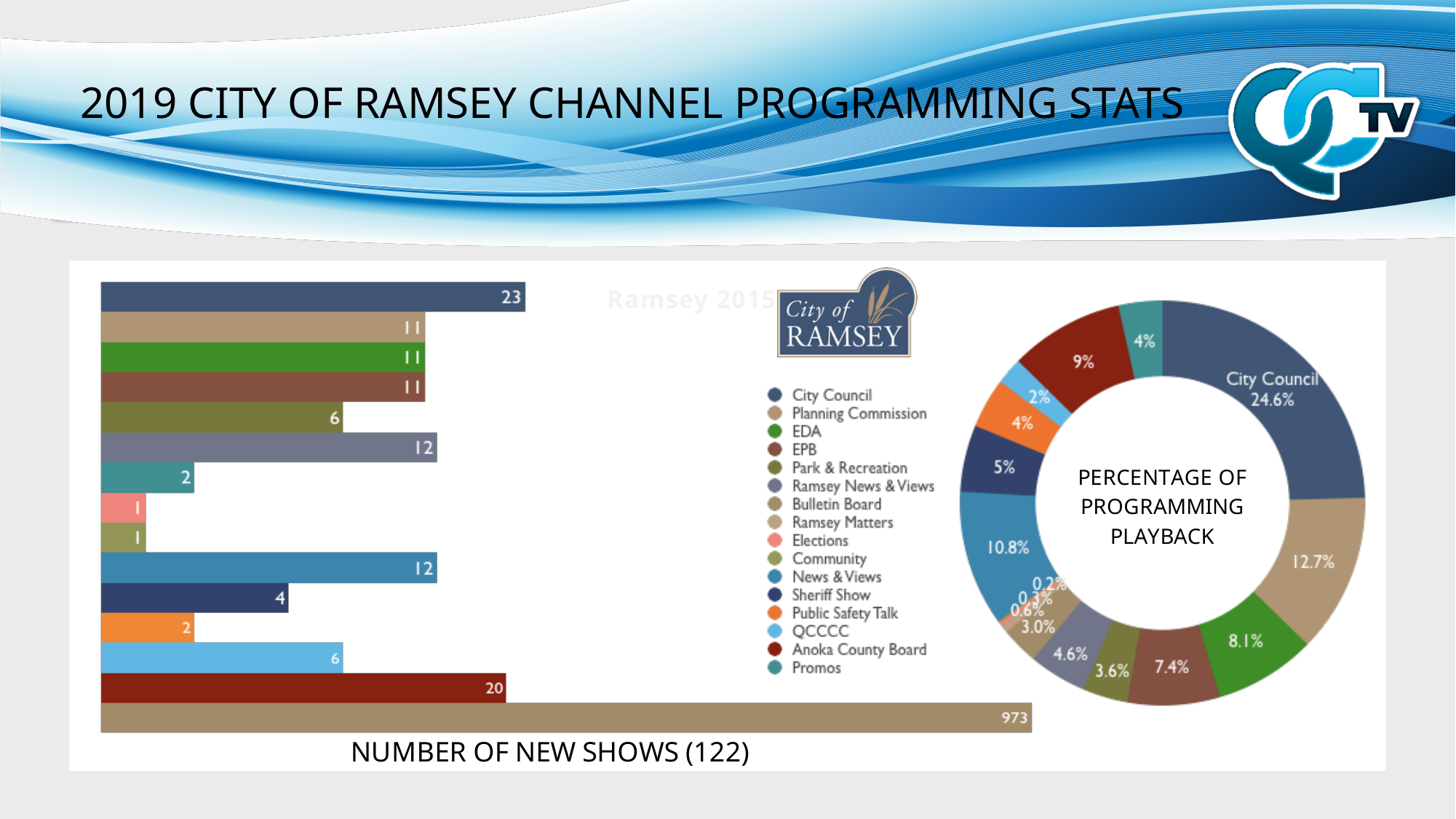
In the pie chart on the right, which is larger: the City Council slice (24.6%) or the 12.7% slice? City Council In the bar chart on the left, what is the value of the longest bar? 973 In the pie chart on the right, what percentage is shown for City Council? 24.6% What kind of chart is the chart on the right of the slide? pie chart In the pie chart on the right, which category has the largest slice? City Council How many bars are in the bar chart on the left? 15 How many entries does the legend between the two charts list? 16 In the bar chart on the left, what is the value of the first (top) bar? 23 What kind of chart is the chart on the left of the slide? bar chart In the bar chart on the left, what is the value of the dark red bar (Anoka County Board)? 20 What is the title printed under the bar chart on the left? NUMBER OF NEW SHOWS (122) In the bar chart on the left, what is the difference between the longest bar (973) and the top bar (23)? 950